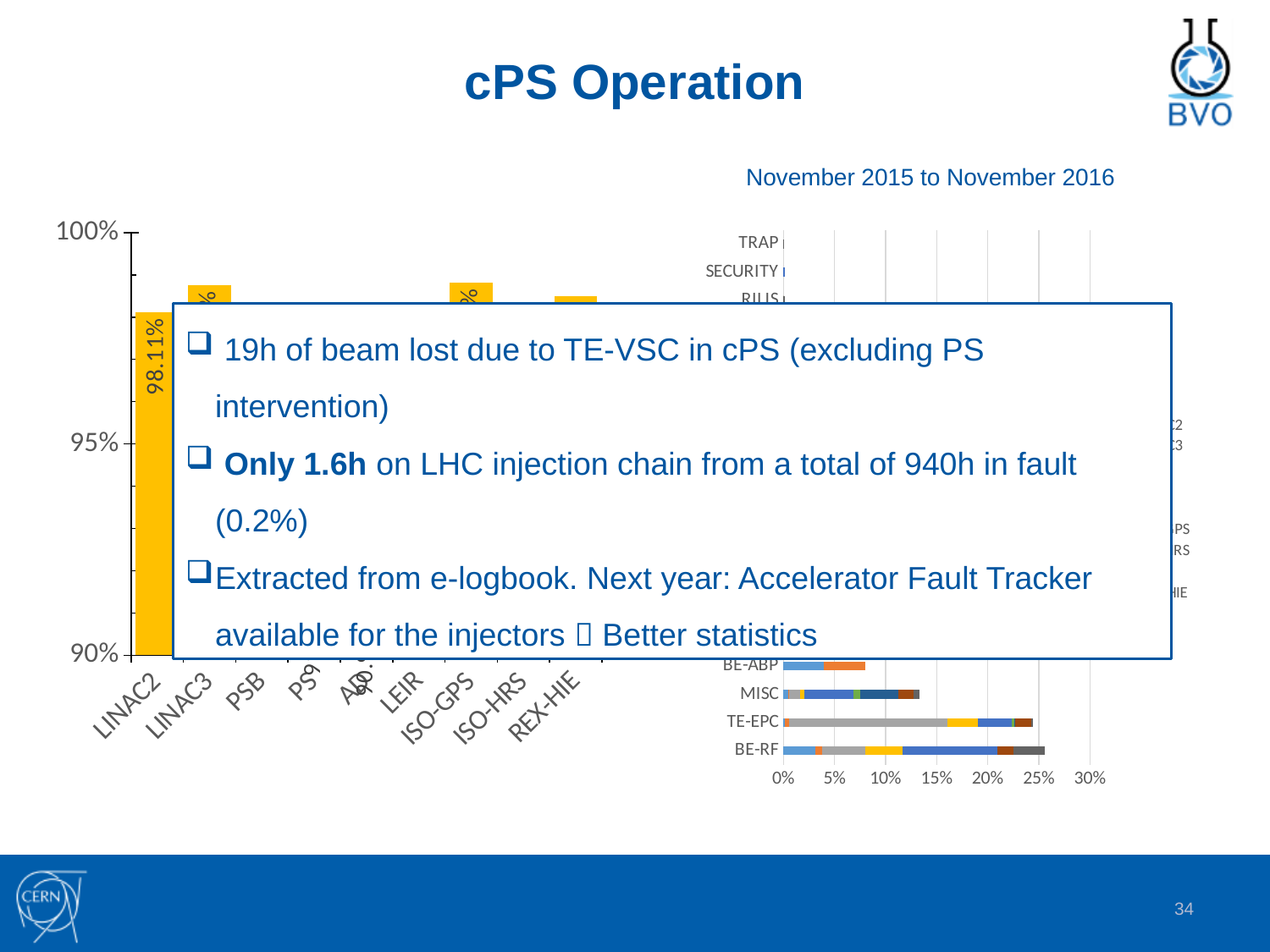
What is the highest tick value shown on the x axis of the right bar chart? 30% How many categories are labelled on the x axis of the left bar chart? 9 What time period is stated above the charts on the slide? November 2015 to November 2016 In the left bar chart, what is the value shown for LINAC2? 98.11% What kind of chart is the chart on the right of the slide? bar chart In the right bar chart, which has the longer bar, MISC or TE-EPC? TE-EPC In the right bar chart, is the total bar length for BE-ABP greater or less than 10%? less In the left bar chart, is the value for LINAC2 greater or less than 95%? greater In the right bar chart, is the total bar length for BE-RF greater or less than 20%? greater In the right bar chart, which has the longer bar, BE-RF or BE-ABP? BE-RF What kind of chart is the chart on the left of the slide? bar chart